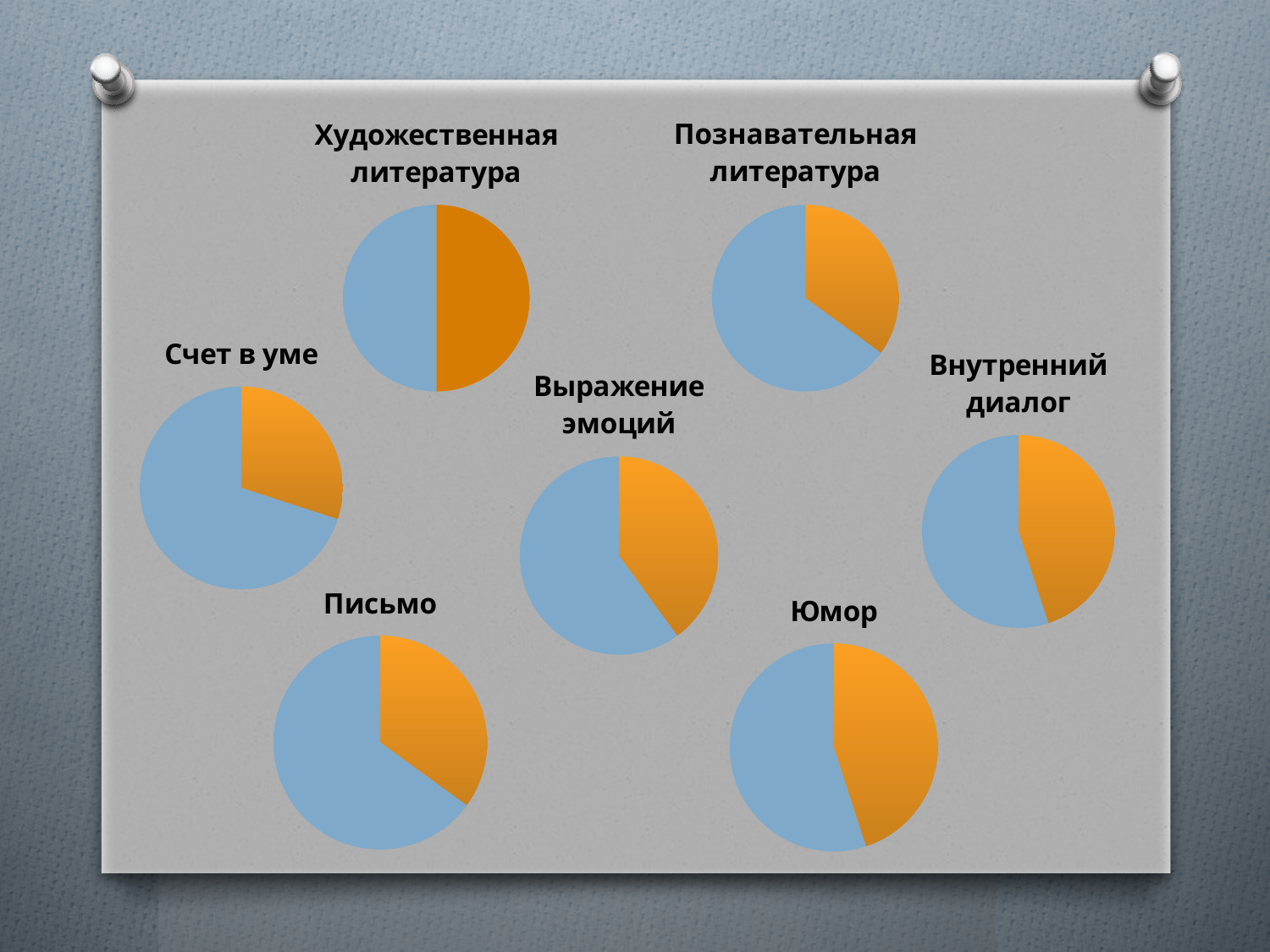
In the "Счет в уме" pie chart, which slice is larger, the blue one or the orange one? Blue In the "Выражение эмоций" pie chart, which slice is larger, the blue one or the orange one? Blue How many slices does the "Юмор" pie chart have? 2 How many slices does the "Письмо" pie chart have? 2 Which pie chart on the slide has the smallest orange slice? Счет в уме How many pie charts are shown on the slide? 7 In the "Письмо" pie chart, which slice is larger, the blue one or the orange one? Blue What kind of chart is used for "Счет в уме"? Pie chart What is the title of the pie chart in the top-left area of the slide? Художественная литература What two colours are used for the slices in the pie charts? Blue and orange